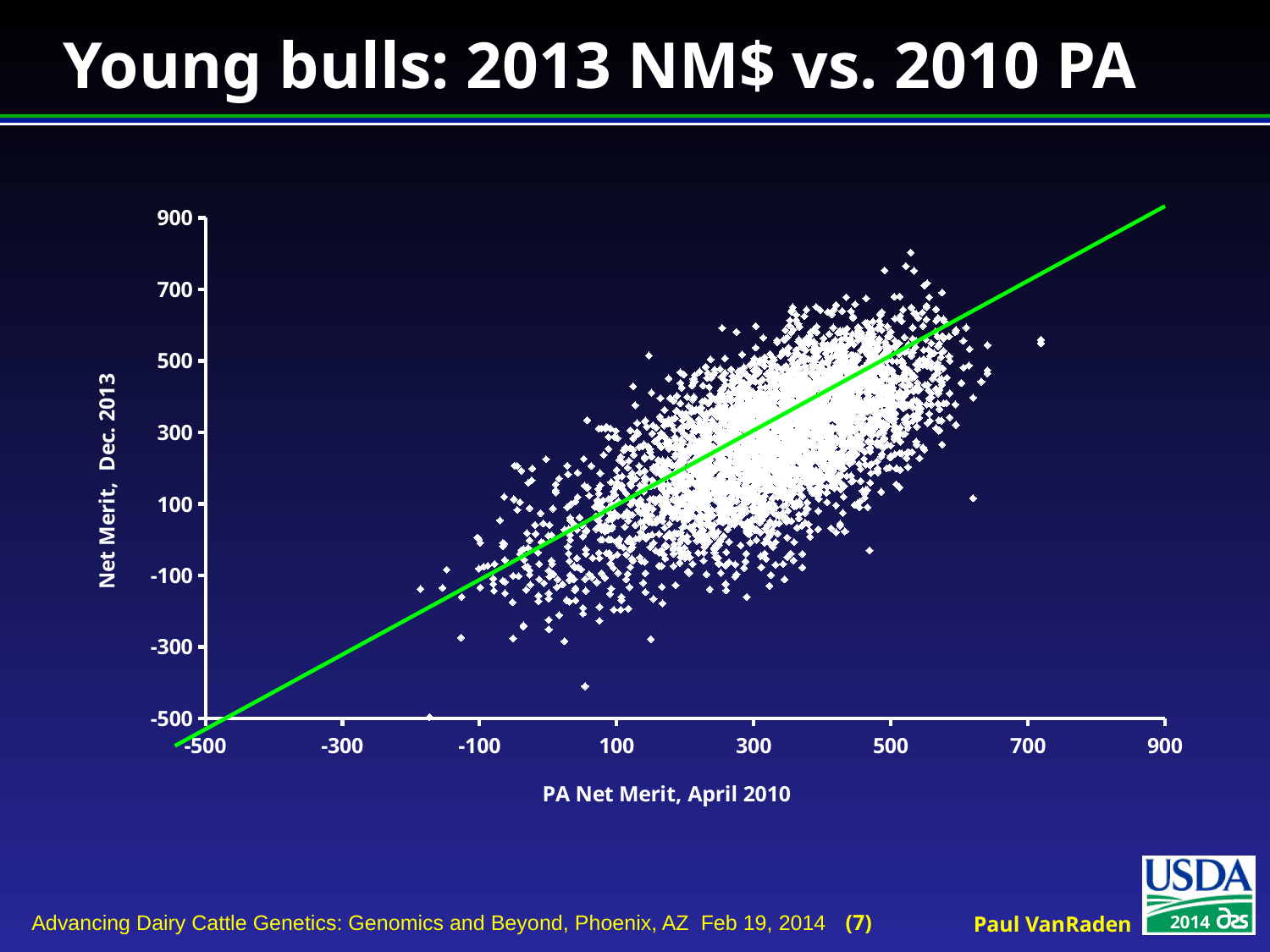
What is the label of the x axis? PA Net Merit, April 2010 Does the green line slope upward or downward from left to right? upward What kind of chart is shown on the slide? scatter plot As PA Net Merit, April 2010 increases along the x axis, does Net Merit, Dec. 2013 tend to rise or fall? rise What is the title of the chart? Young bulls: 2013 NM$ vs. 2010 PA